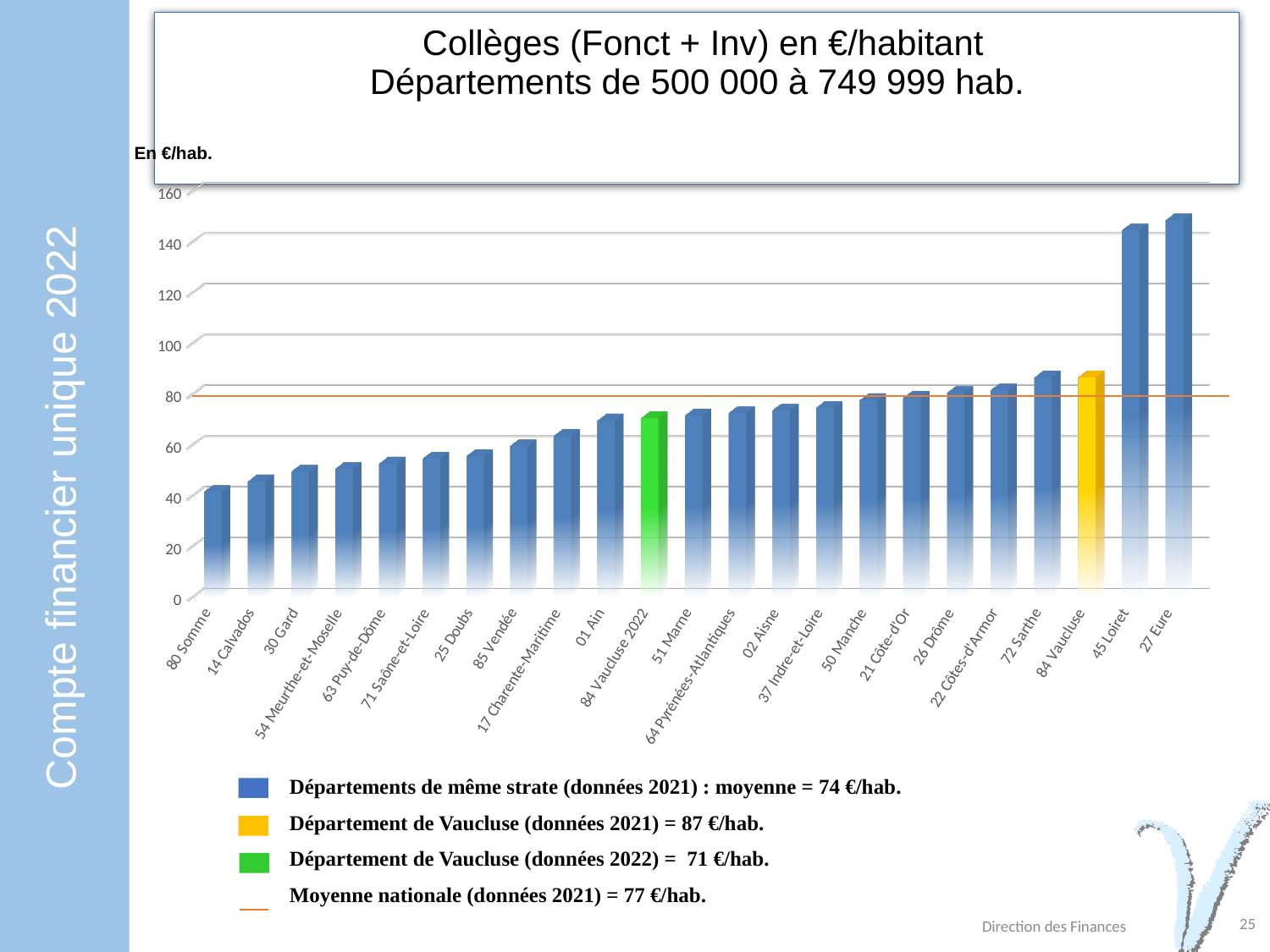
What kind of chart is shown on the slide? Bar chart Which has the larger value, 27 Eure or 80 Somme? 27 Eure Which category has the lowest value in the chart? 80 Somme What is the Moyenne nationale (données 2021) shown in the legend? 77 €/hab. What colour is the bar for 84 Vaucluse 2022? Green Is the value for 45 Loiret greater or less than 140? greater Is the value for 80 Somme greater or less than 60? less Which category has the highest value in the chart? 27 Eure How many bars are plotted in the chart? 23 What is the difference between the Vaucluse 2021 value and the Vaucluse 2022 value? 16 €/hab. According to the legend, what is the value for Département de Vaucluse (données 2021)? 87 €/hab. According to the legend, what is the value for Département de Vaucluse (données 2022)? 71 €/hab.